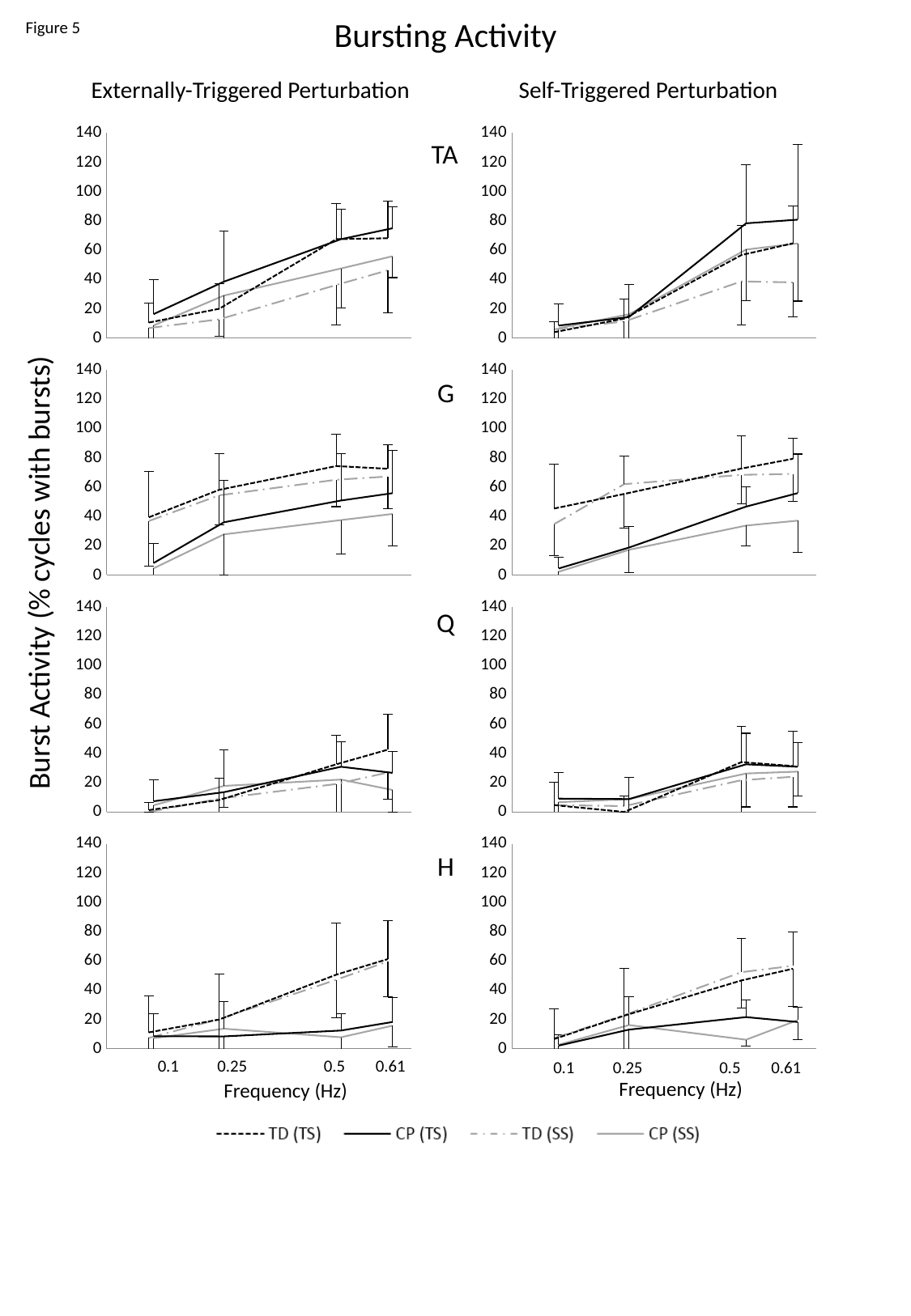
In the Self-Triggered Perturbation G panel, does the CP (TS) line rise or fall from 0.1 Hz to 0.61 Hz? rise In the Self-Triggered Perturbation H panel, is the TD (SS) value at 0.61 Hz greater or less than 40? greater How many frequency values are plotted along the x axis of the Self-Triggered Perturbation H panel? 4 What is the x-axis label of the charts on the slide? Frequency (Hz) What kind of chart is used for the Externally-Triggered Perturbation TA panel? line chart In the Externally-Triggered Perturbation TA panel, is the CP (TS) value at 0.61 Hz greater or less than 60? greater In the Self-Triggered Perturbation TA panel, which series has the highest value at 0.5 Hz? CP (TS) In the Externally-Triggered Perturbation G panel, which is larger at 0.1 Hz: TD (TS) or CP (TS)? TD (TS) In the Self-Triggered Perturbation TA panel, does the CP (TS) line rise or fall from 0.1 Hz to 0.61 Hz? rise What is the y-axis label shared by the charts on the slide? Burst Activity (% cycles with bursts) How many series does the legend at the bottom of the slide list? 4 In the Externally-Triggered Perturbation H panel, is the CP (SS) value at 0.5 Hz greater or less than 20? less